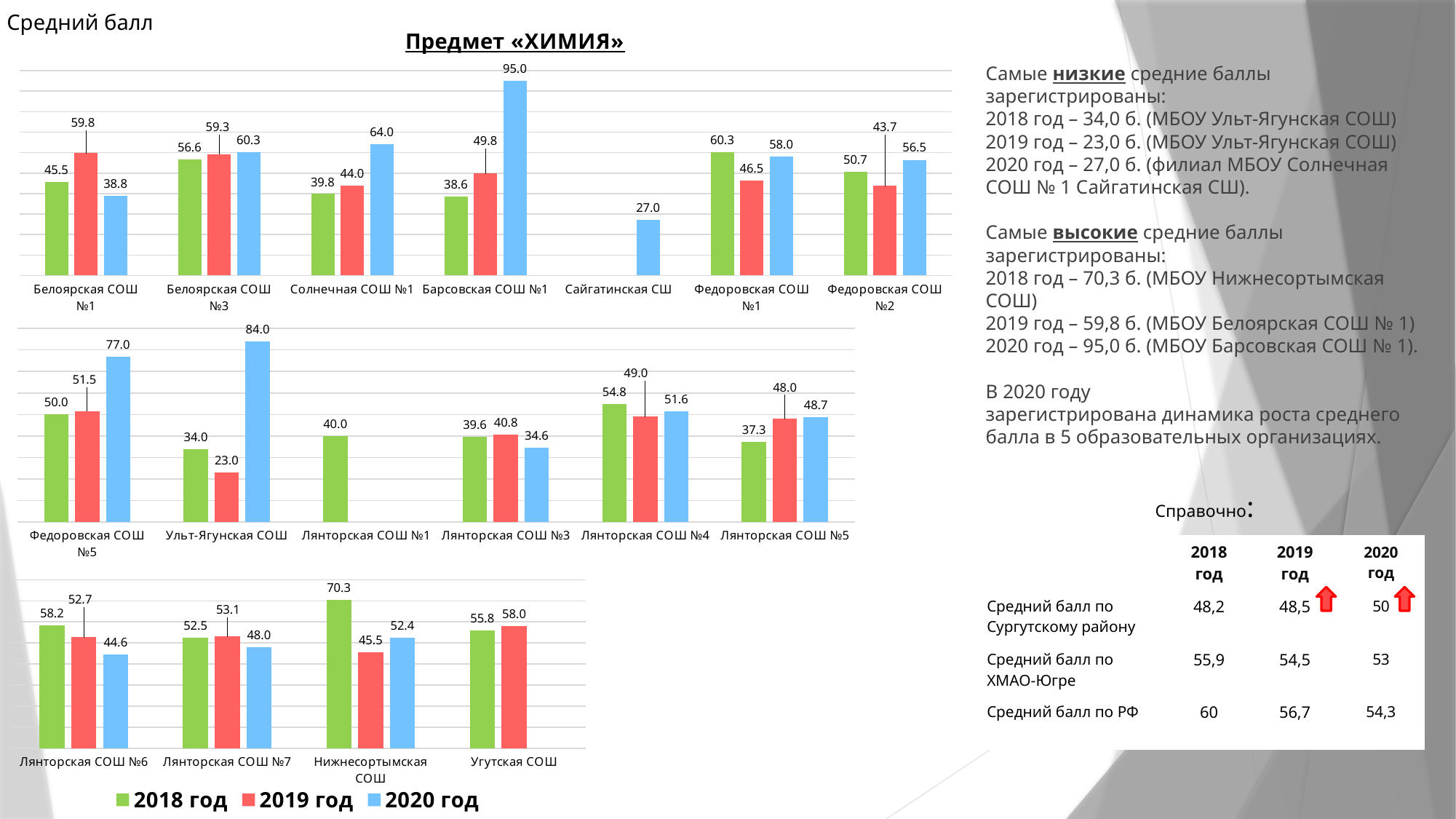
In the bottom chart, what is the 2019 год value for Угутская СОШ? 58.0 Which colour represents the 2020 год series in the legend? blue In the bottom chart, what is the difference between the 2018 год and 2019 год values for Нижнесортымская СОШ? 24.8 What kind of chart is the middle chart? bar chart In the top chart, what is the 2019 год value for Белоярская СОШ №1? 59.8 How many series does the legend list? 3 How many schools (categories) are shown in the bottom chart? 4 In the top chart, what is the 2020 год value for Барсовская СОШ №1? 95.0 In the middle chart, which school has the lowest 2019 год value? Ульт-Ягунская СОШ In the top chart, which is larger for Федоровская СОШ №1: the 2018 год value or the 2020 год value? 2018 год In the middle chart, what is the 2018 год value for Лянторская СОШ №1? 40.0 In the middle chart, which school has the highest 2020 год value? Ульт-Ягунская СОШ